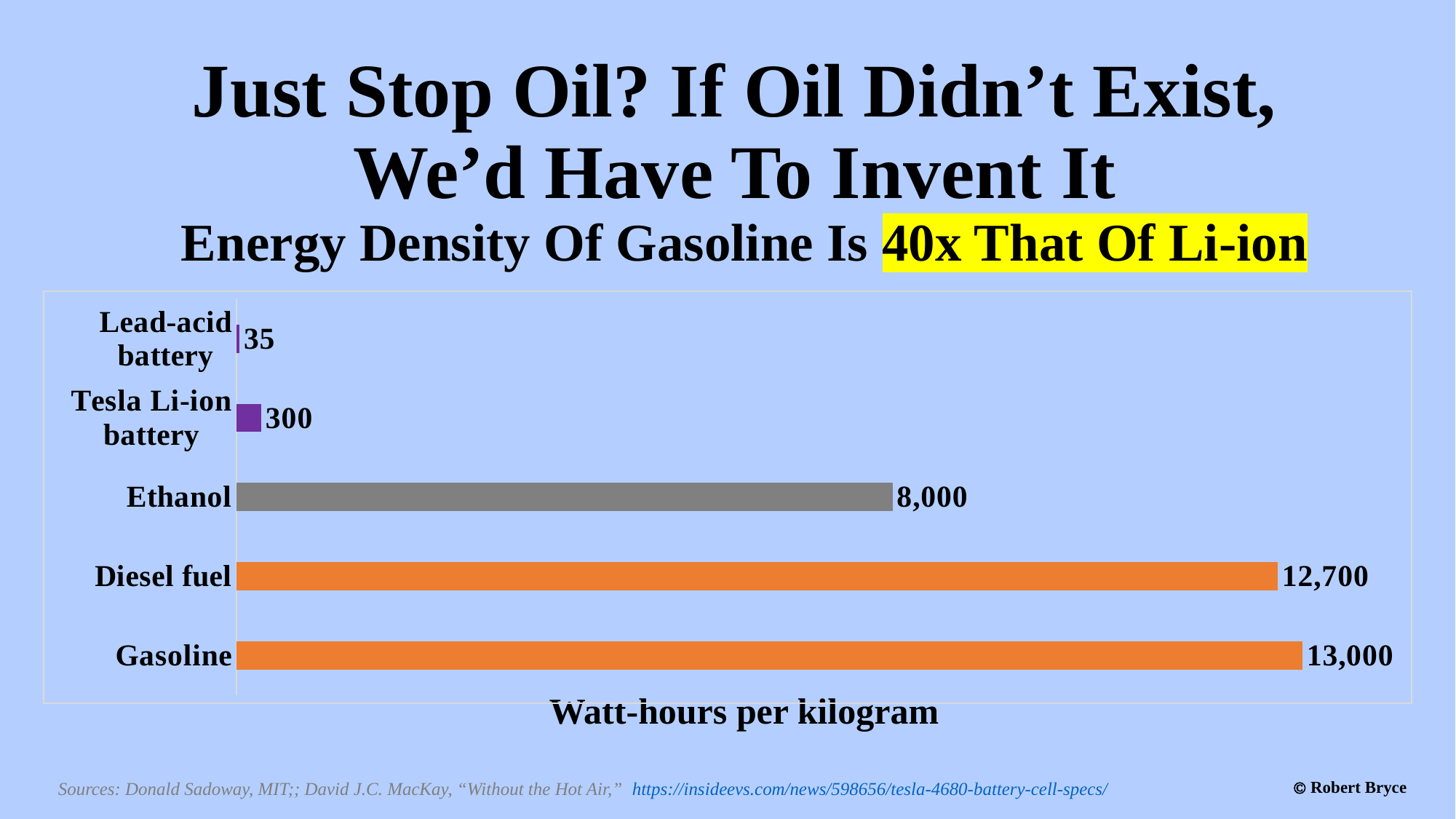
Which category has the highest value in the chart? Gasoline What is the energy density value shown for Gasoline? 13,000 What is the value shown for Diesel fuel? 12,700 What is the difference between the values for Gasoline and Diesel fuel? 300 What is the difference between the values for Ethanol and the Tesla Li-ion battery? 7,700 Which has a larger value, Ethanol or Diesel fuel? Diesel fuel What is the value shown for Ethanol? 8,000 Which category has the lowest value in the chart? Lead-acid battery What is the value shown for the Tesla Li-ion battery? 300 What is the value shown for the Lead-acid battery? 35 How many categories are plotted in the chart? 5 What type of chart is shown on the slide? Bar chart